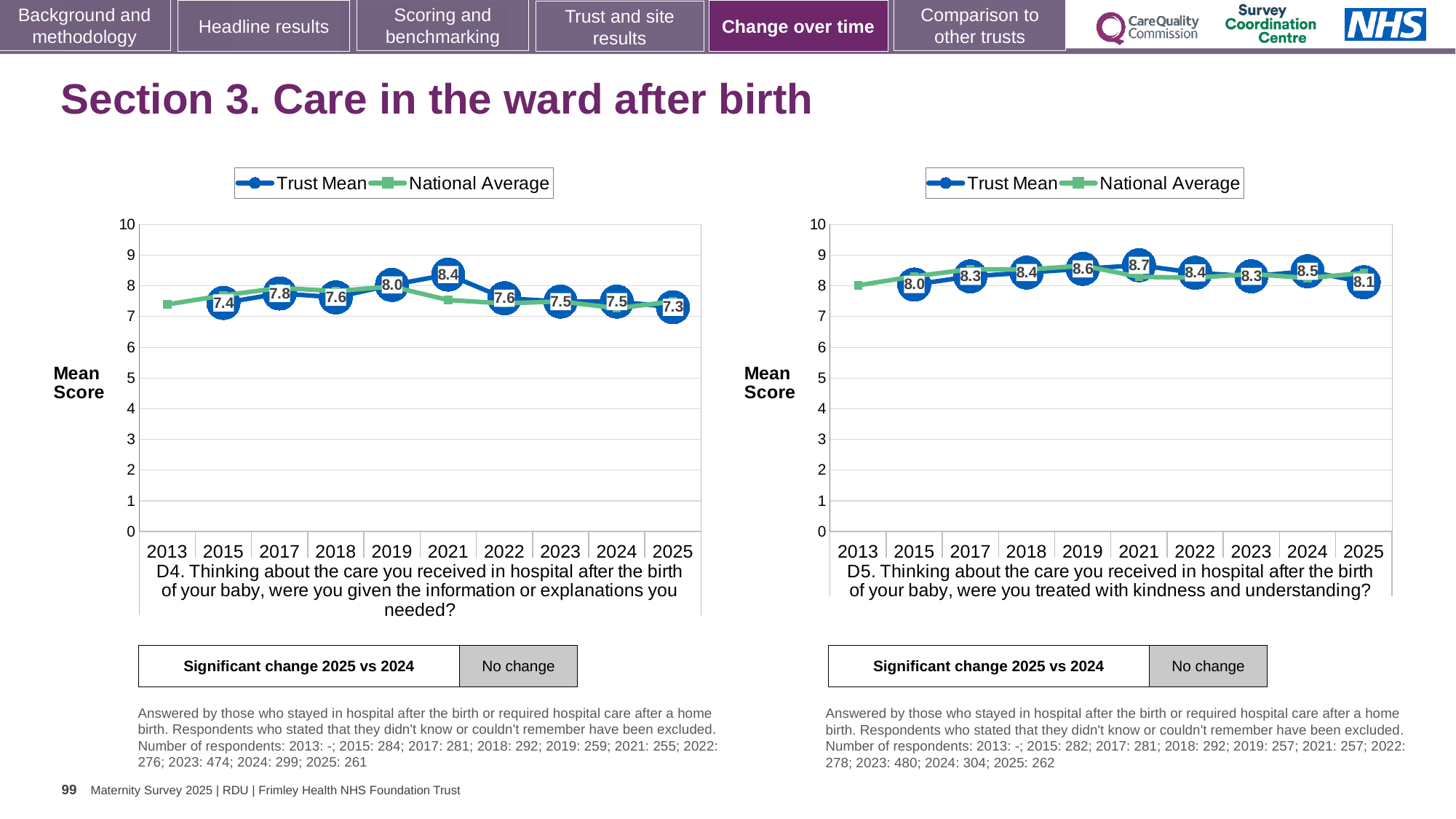
In the D4 chart on the left, what is the Trust Mean score for 2021? 8.4 What kind of chart is the D4 chart on the left? Line chart In the D4 chart on the left, which year has the highest Trust Mean score? 2021 In the D4 chart on the left, does the Trust Mean score rise or fall from 2021 to 2025? Fall In the D4 chart on the left, what is the difference between the Trust Mean scores for 2021 and 2025? 1.1 How many series does the legend of the D5 chart on the right list? 2 In the D5 chart on the right, what is the Trust Mean score for 2025? 8.1 In the D5 chart on the right, which year has the highest Trust Mean score? 2021 In the D4 chart on the left, which year has the lowest Trust Mean score? 2025 In the D5 chart on the right, which is larger, the Trust Mean score for 2019 or for 2025? 2019 How many years are shown on the x axis of the D5 chart on the right? 10 In the D4 chart on the left, is the National Average value for 2013 greater or less than 8? less